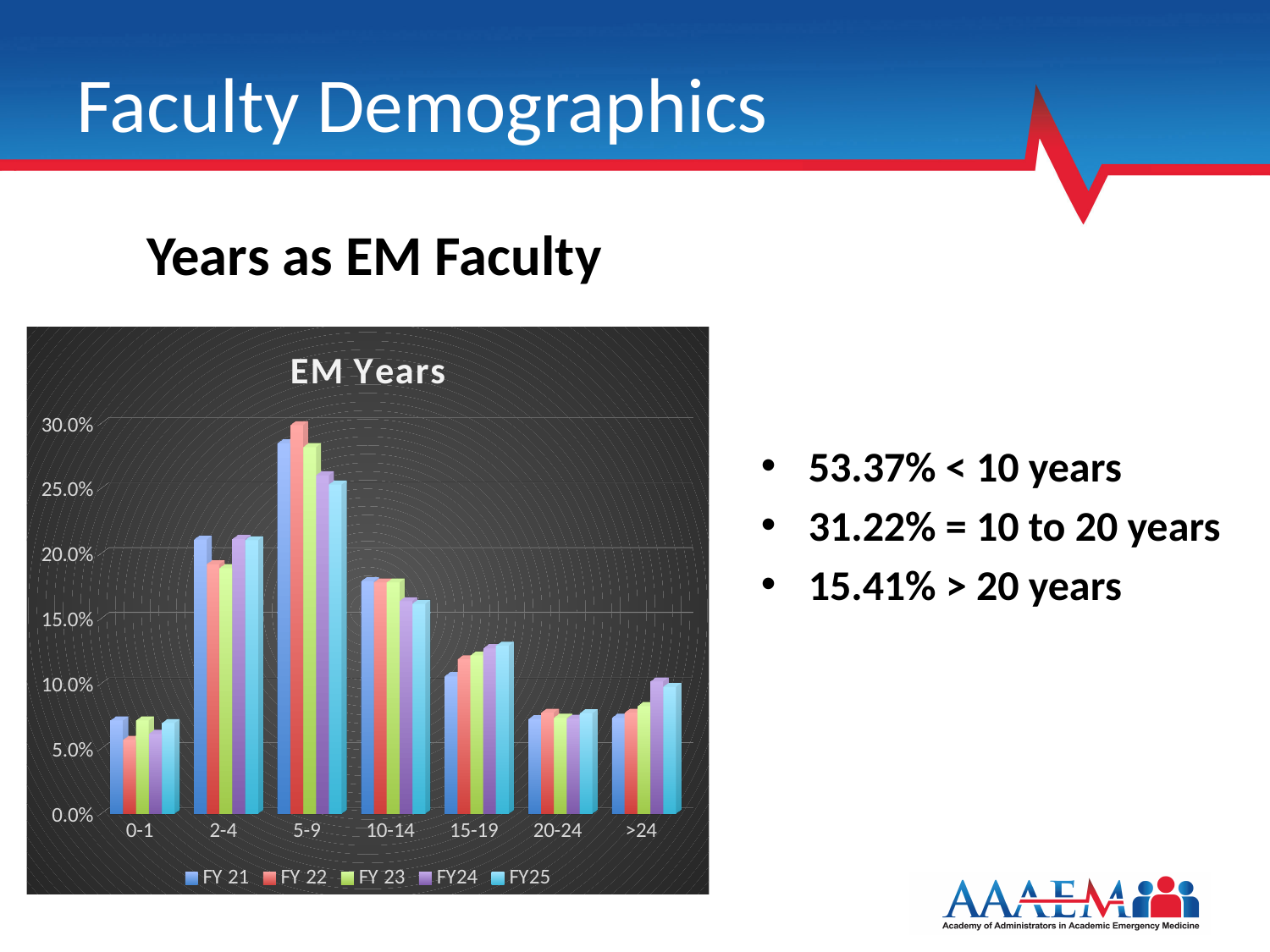
Is the FY 22 value for the 2-4 category greater or less than 20.0%? less What kind of chart is shown on the slide? bar chart Which series are listed in the chart legend? FY 21, FY 22, FY 23, FY24, FY25 Is the FY25 value for the 15-19 category greater or less than 15.0%? less How many series does the chart legend list? 5 Which category has the highest bars in the chart? 5-9 Do the FY 21 values rise or fall from the 5-9 category to the 20-24 category? fall Is the FY 21 value for the 5-9 category greater or less than 25.0%? greater For FY 21, which is larger: the value for 10-14 or the value for 15-19? 10-14 How many year-range categories are shown on the x axis of the chart? 7 What is the title of the chart? EM Years